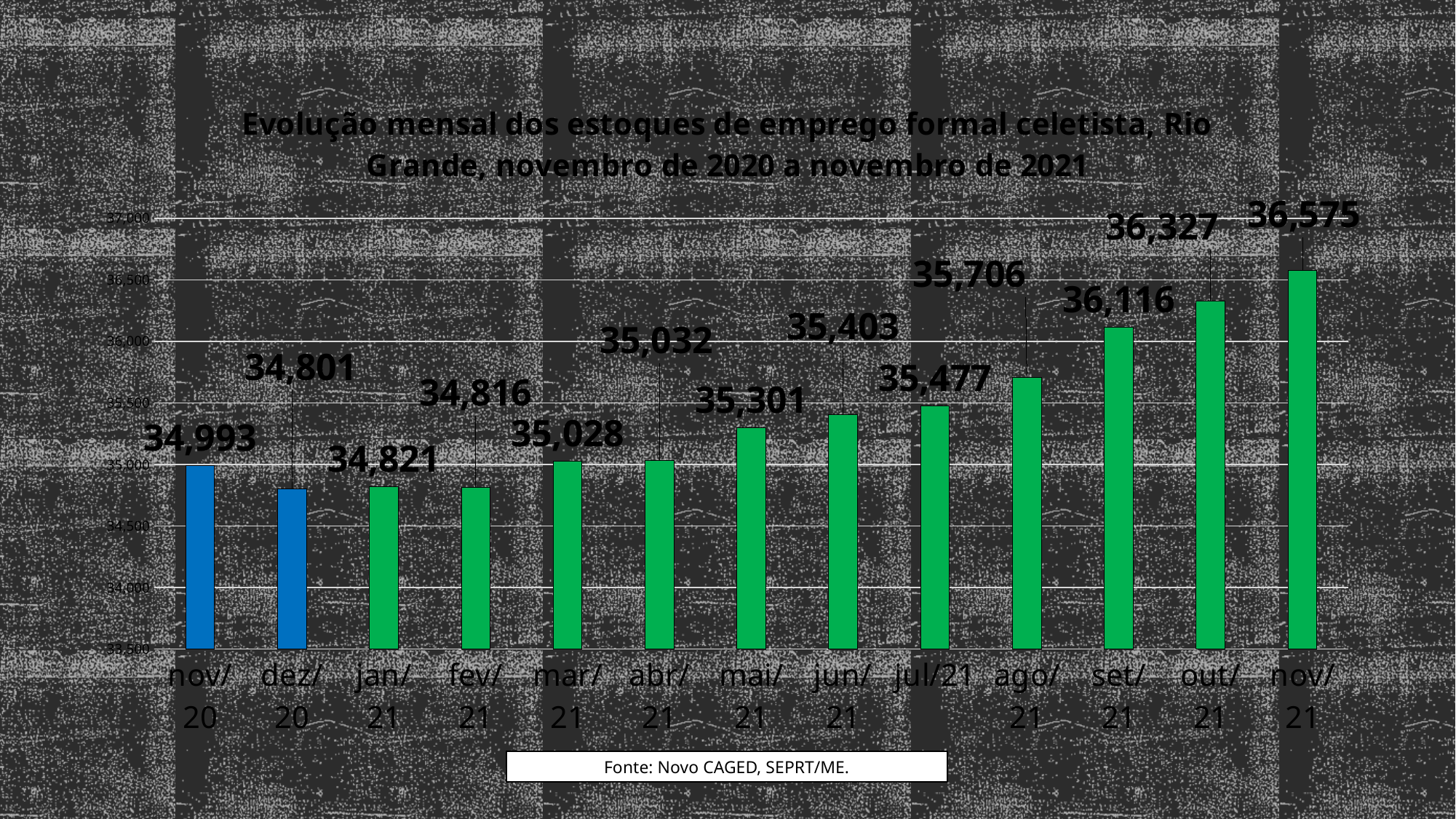
What kind of chart is shown on the slide? bar chart Which month has the lowest value? dez/20 Which is larger, the value for mar/21 or the value for abr/21? abr/21 What is the difference between the values for out/21 and set/21? 211 What is the value for nov/20? 34,993 How many months are shown on the x axis? 13 Which month has the highest value? nov/21 What is the value for jul/21? 35,477 What is the difference between the values for nov/21 and nov/20? 1,582 Do the values generally rise or fall from jan/21 to nov/21? rise Is the value for ago/21 greater or less than 36,000? less What is the value for set/21? 36,116